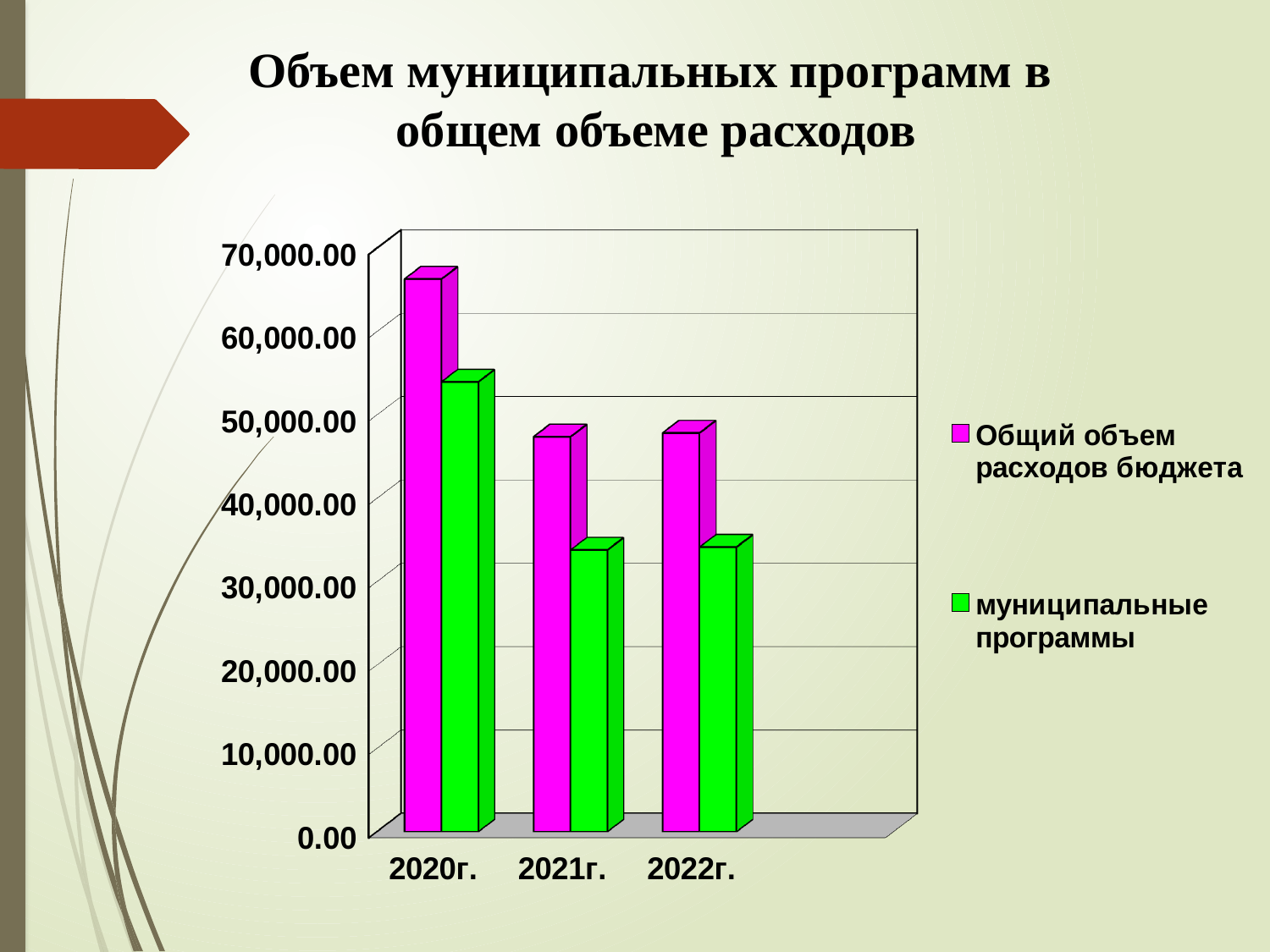
What colour are the bars for муниципальные программы? green In 2020г., which is larger: Общий объем расходов бюджета or муниципальные программы? Общий объем расходов бюджета Is the value for муниципальные программы in 2022г. greater or less than 30,000.00? greater Is the value for Общий объем расходов бюджета in 2021г. greater or less than 50,000.00? less Does the value for Общий объем расходов бюджета rise or fall from 2020г. to 2021г.? fall Is the value for Общий объем расходов бюджета in 2020г. greater or less than 60,000.00? greater Which year has the highest value for Общий объем расходов бюджета? 2020г. Which year has the highest value for муниципальные программы? 2020г. What kind of chart is shown on the slide? bar chart How many series does the legend list? 2 How many years are shown on the x axis? 3